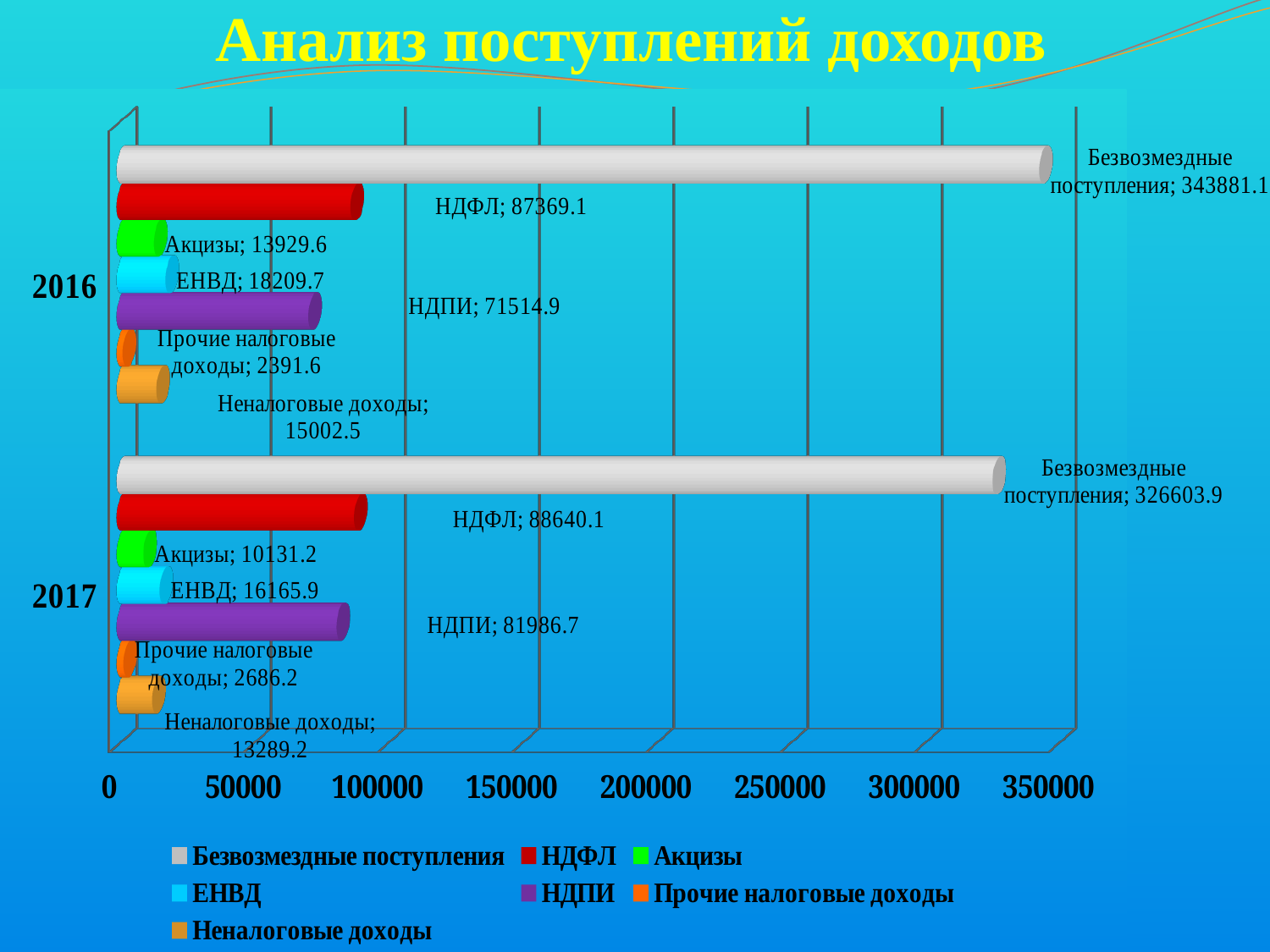
What is the value of Неналоговые доходы for 2017? 13289.2 Which is larger: ЕНВД in 2016 or ЕНВД in 2017? ЕНВД in 2016 Which series has the highest value for 2017? Безвозмездные поступления What is the difference between Безвозмездные поступления in 2016 and in 2017? 17277.2 What is the value of Безвозмездные поступления for 2016? 343881.1 What is the value of Акцизы for 2016? 13929.6 How many series does the legend list? 7 What is the difference between НДПИ in 2017 and in 2016? 10471.8 Which series has the lowest value for 2016? Прочие налоговые доходы What type of chart is shown on the slide? bar chart What is the value of НДПИ for 2017? 81986.7 What is the title of the chart? Анализ поступлений доходов